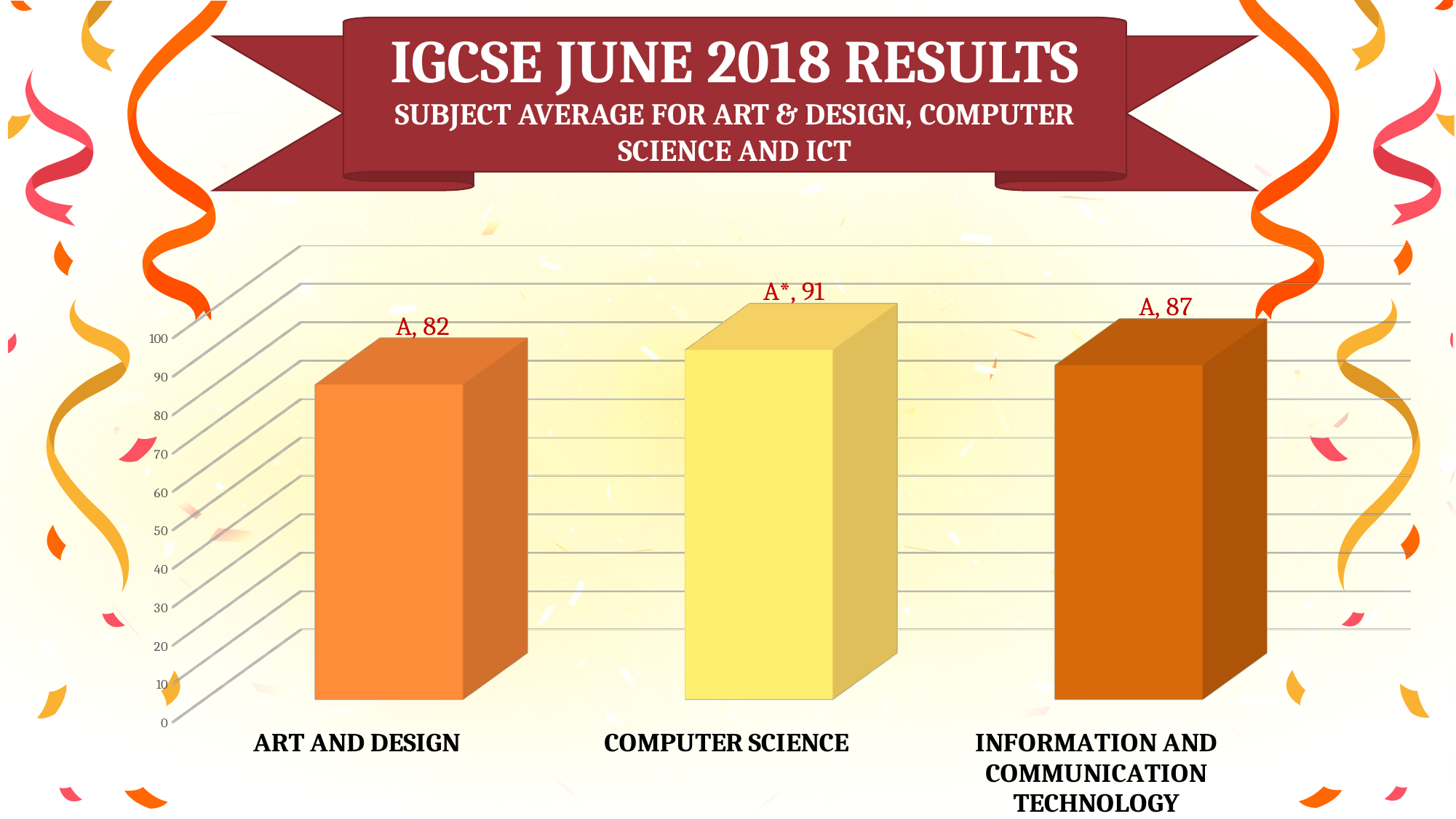
What is the subject average for Information and Communication Technology? 87 What kind of chart is shown on the slide? bar chart Which subject has the highest average? Computer Science Which is larger, the average for Computer Science or for Information and Communication Technology? Computer Science Is the value for Art and Design greater or less than 90? less What is the subject average for Art and Design? 82 What is the subject average for Computer Science? 91 Which subject has the lowest average? Art and Design What grade label is shown on the Computer Science bar? A* How many subjects are shown in the chart? 3 What is the difference between the Computer Science average and the Art and Design average? 9 What is the difference between the Information and Communication Technology average and the Art and Design average? 5